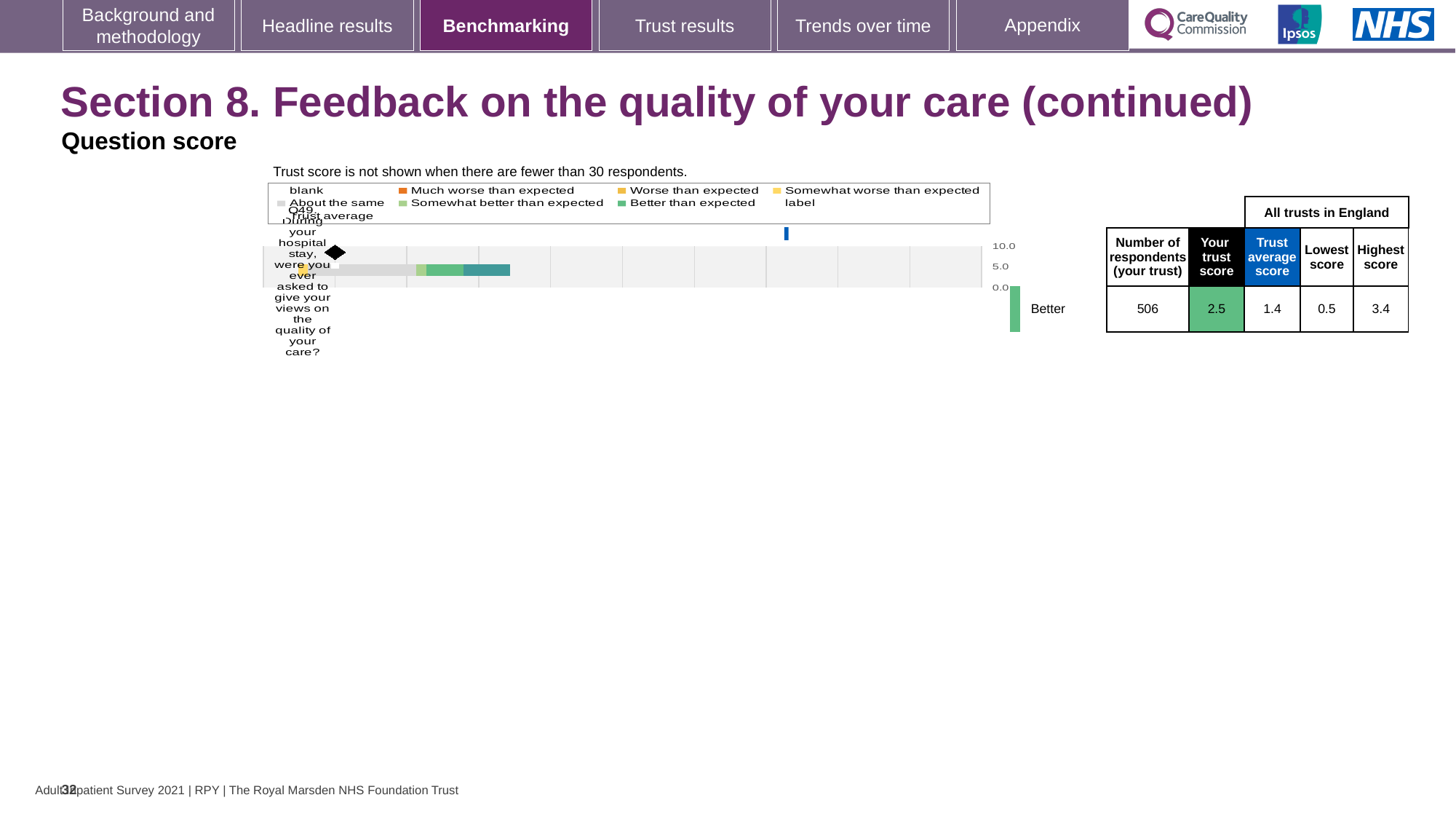
What is the trust score for Q49 shown in the table? 2.5 How many questions (categories) are plotted in the chart? 1 What is the number of respondents for Q49 at your trust? 506 What is the difference between the highest and lowest scores among all trusts in England for Q49? 2.9 What is the trust average score for Q49? 1.4 What is the difference between your trust score and the trust average score for Q49? 1.1 What colour does the legend use for 'Much worse than expected'? Orange What kind of chart is shown on the slide? Bar chart What is the lowest score among all trusts in England for Q49? 0.5 Which question number is plotted in the chart? Q49 Which is larger for Q49: your trust score or the trust average score? Your trust score What is the highest score among all trusts in England for Q49? 3.4